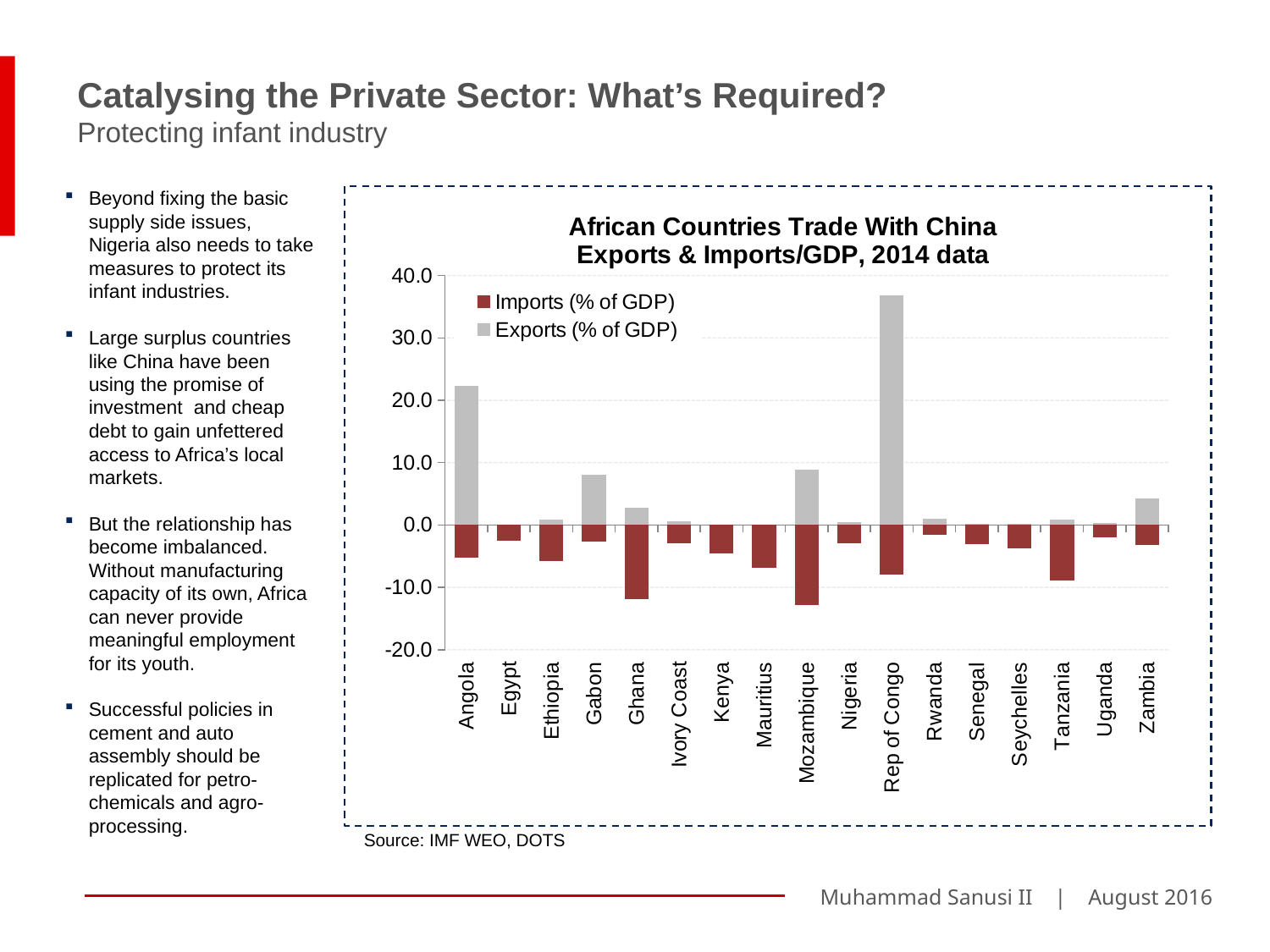
Is the Imports (% of GDP) value for Ghana greater or less than -10.0? less How many series does the legend list? 2 Is the Exports (% of GDP) value for Gabon greater or less than 10.0? less Which colour represents Imports (% of GDP) in the chart? dark red What kind of chart is shown on the slide? bar chart What is the title of the chart? African Countries Trade With China Exports & Imports/GDP, 2014 data Which country has the highest Exports (% of GDP) value? Rep of Congo Is the Exports (% of GDP) value for Rep of Congo greater or less than 30.0? greater Which has the larger Exports (% of GDP) value, Gabon or Zambia? Gabon Which has the larger Exports (% of GDP) value, Angola or Mozambique? Angola How many countries are shown on the x axis? 17